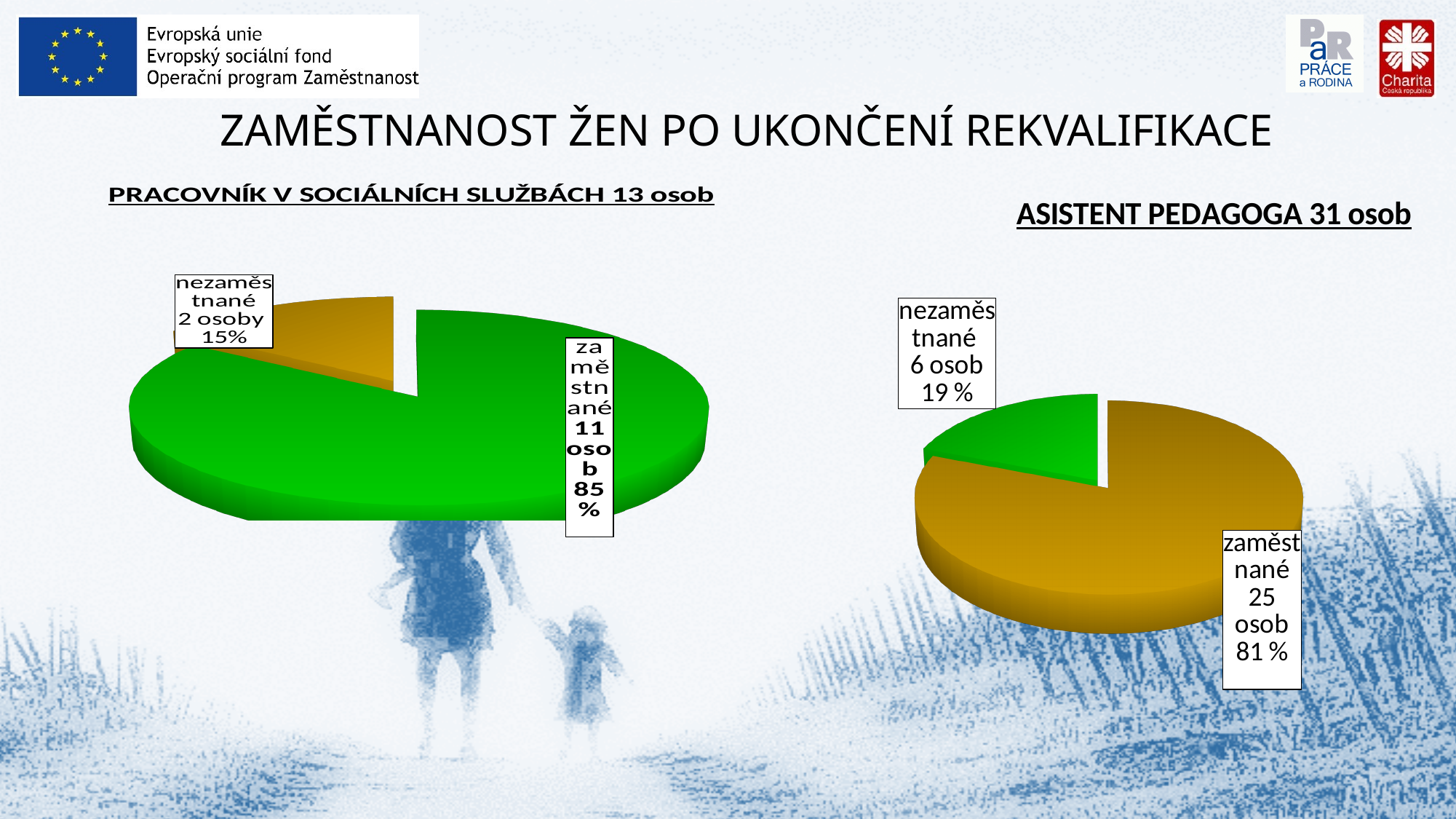
In the PRACOVNÍK V SOCIÁLNÍCH SLUŽBÁCH chart, how many slices does the pie have? 2 In the ASISTENT PEDAGOGA 31 osob chart, which slice is the smallest? nezaměstnané In the PRACOVNÍK V SOCIÁLNÍCH SLUŽBÁCH chart, what share of the pie is nezaměstnané? 15% In the ASISTENT PEDAGOGA 31 osob chart, what is the difference in number of people between zaměstnané and nezaměstnané? 19 In the PRACOVNÍK V SOCIÁLNÍCH SLUŽBÁCH chart, how many people are zaměstnané? 11 osob In the ASISTENT PEDAGOGA 31 osob chart, how many people are nezaměstnané? 6 osob In the PRACOVNÍK V SOCIÁLNÍCH SLUŽBÁCH chart, which slice is the largest? zaměstnané In the ASISTENT PEDAGOGA 31 osob chart, what share of the pie is zaměstnané? 81 % In the ASISTENT PEDAGOGA 31 osob chart, what share of the pie is nezaměstnané? 19 % What kind of chart is used for PRACOVNÍK V SOCIÁLNÍCH SLUŽBÁCH 13 osob? Pie chart In the ASISTENT PEDAGOGA 31 osob chart, what colour is the zaměstnané slice? Gold/brown